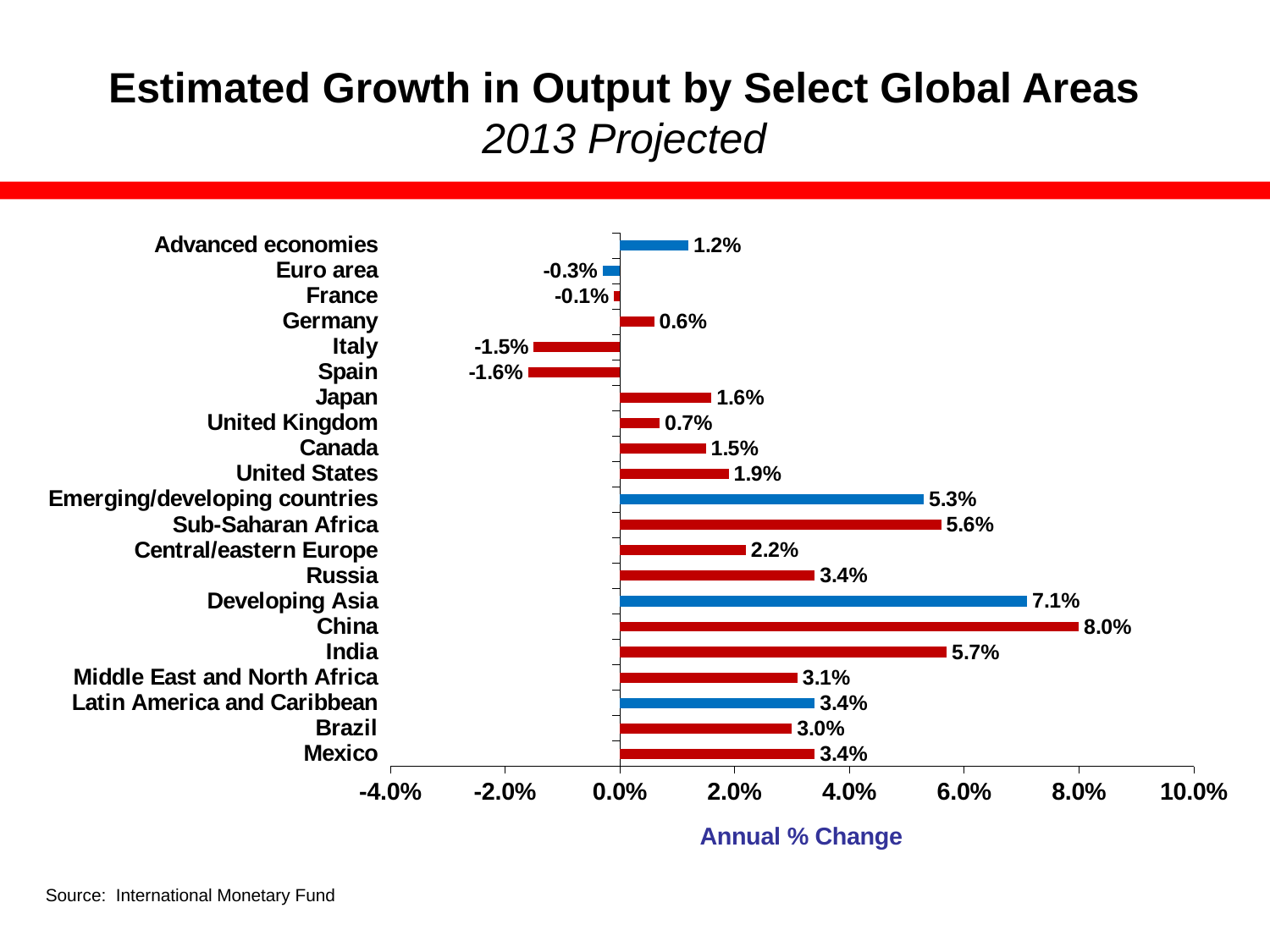
What is the difference between the values for India and Sub-Saharan Africa? 0.1% What is the difference between the values for Developing Asia and Advanced economies? 5.9% How many areas are listed on the chart? 21 What is the value shown for Emerging/developing countries? 5.3% Which area has the highest projected growth in output? China Which has a larger value, Russia or Central/eastern Europe? Russia What is the value shown for the United Kingdom? 0.7% What is the value shown for Spain? -1.6% What kind of chart is shown on the slide? Bar chart What is the projected 2013 growth in output for China? 8.0% What is the label of the horizontal axis? Annual % Change Which area has the lowest projected growth in output? Spain